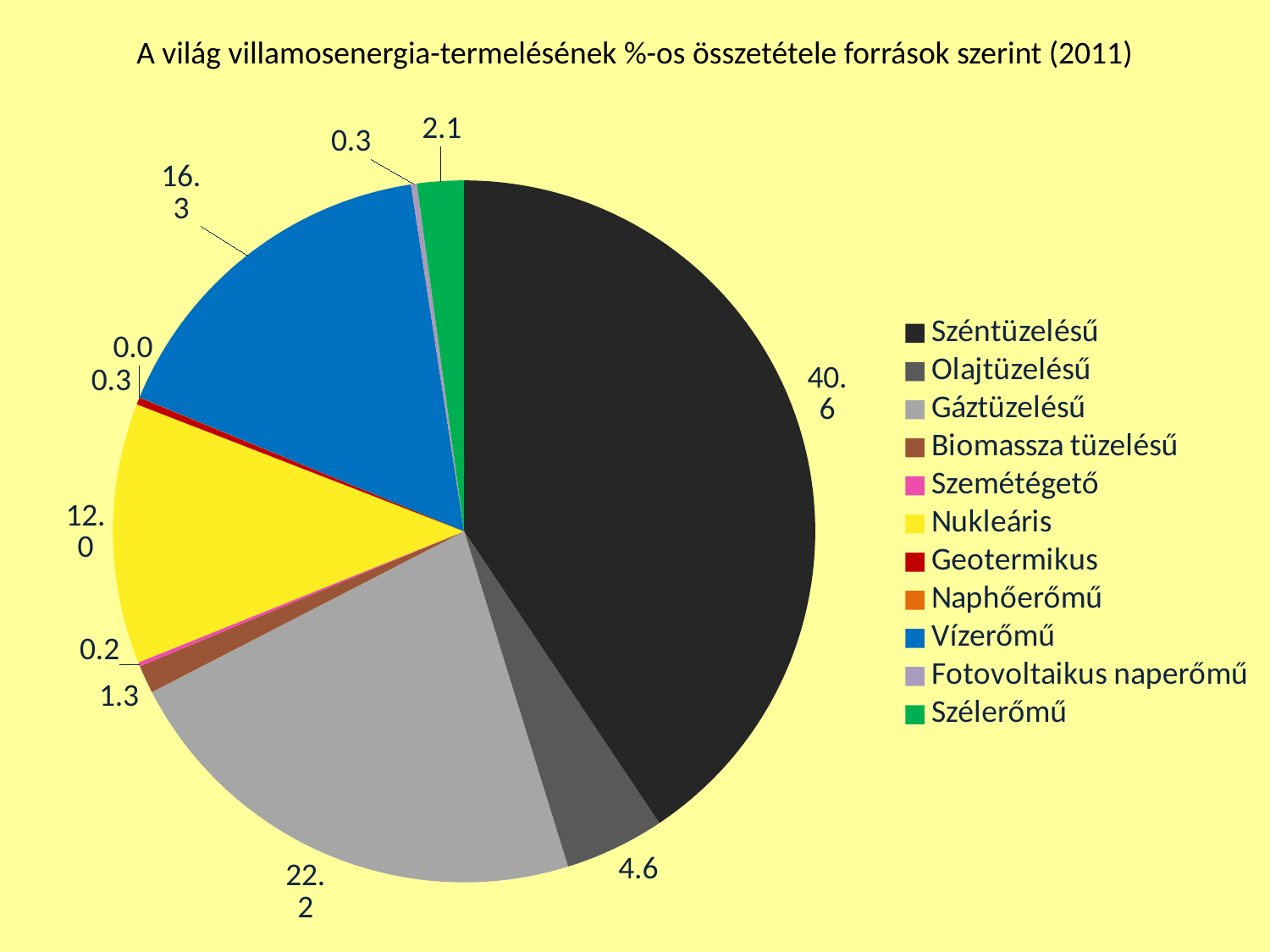
What is the value for Gáztüzelésű? 22.2 What is the value for Szélerőmű? 2.1 What is the value for Széntüzelésű? 40.6 Which source has the smallest value in the chart? Naphőerőmű What is the title of the chart? A világ villamosenergia-termelésének %-os összetétele források szerint (2011) Which source has the largest slice of the pie? Széntüzelésű What is the difference between the values for Széntüzelésű and Gáztüzelésű? 18.4 Which is larger, the value for Vízerőmű or the value for Nukleáris? Vízerőmű What is the value for Nukleáris? 12.0 What is the value for Vízerőmű? 16.3 How many sources does the legend list? 11 What kind of chart is shown on the slide? pie chart